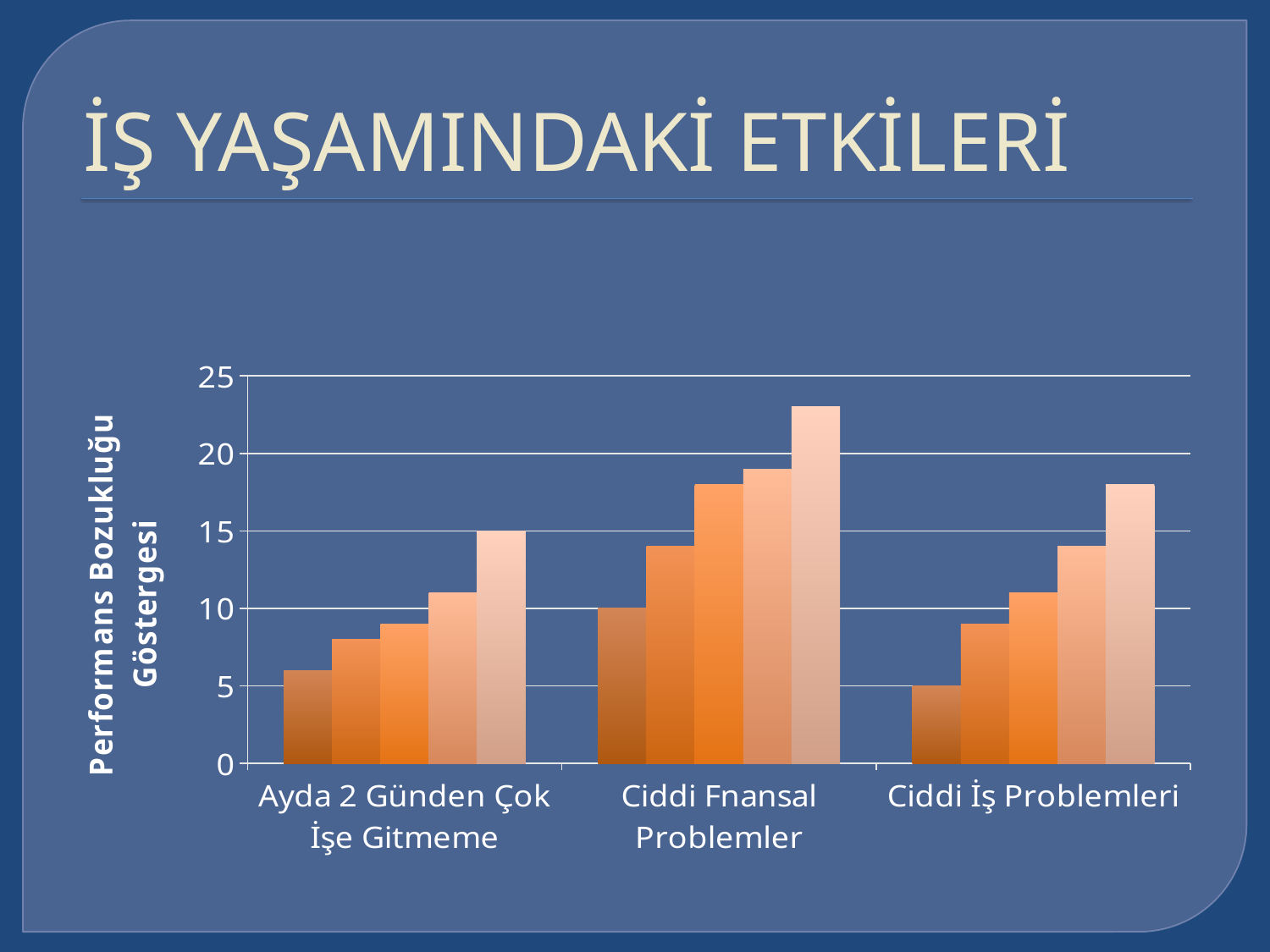
Which category contains the tallest bar in the chart? Ciddi Fnansal Problemler Is the tallest bar for Ayda 2 Günden Çok İşe Gitmeme greater or less than 20? less Is the tallest bar for Ciddi İş Problemleri greater or less than 20? less What kind of chart is shown on the slide? bar chart Is the shortest bar for Ayda 2 Günden Çok İşe Gitmeme greater or less than 5? greater What is the label of the vertical axis of the chart? Performans Bozukluğu Göstergesi How many bars are plotted for each category in the chart? 5 How many categories are shown on the x axis of the chart? 3 What is the highest value shown on the vertical axis of the chart? 25 Which is larger: the leftmost bar for Ciddi Fnansal Problemler or the leftmost bar for Ciddi İş Problemleri? Ciddi Fnansal Problemler Which is larger: the tallest bar for Ciddi Fnansal Problemler or the tallest bar for Ayda 2 Günden Çok İşe Gitmeme? Ciddi Fnansal Problemler